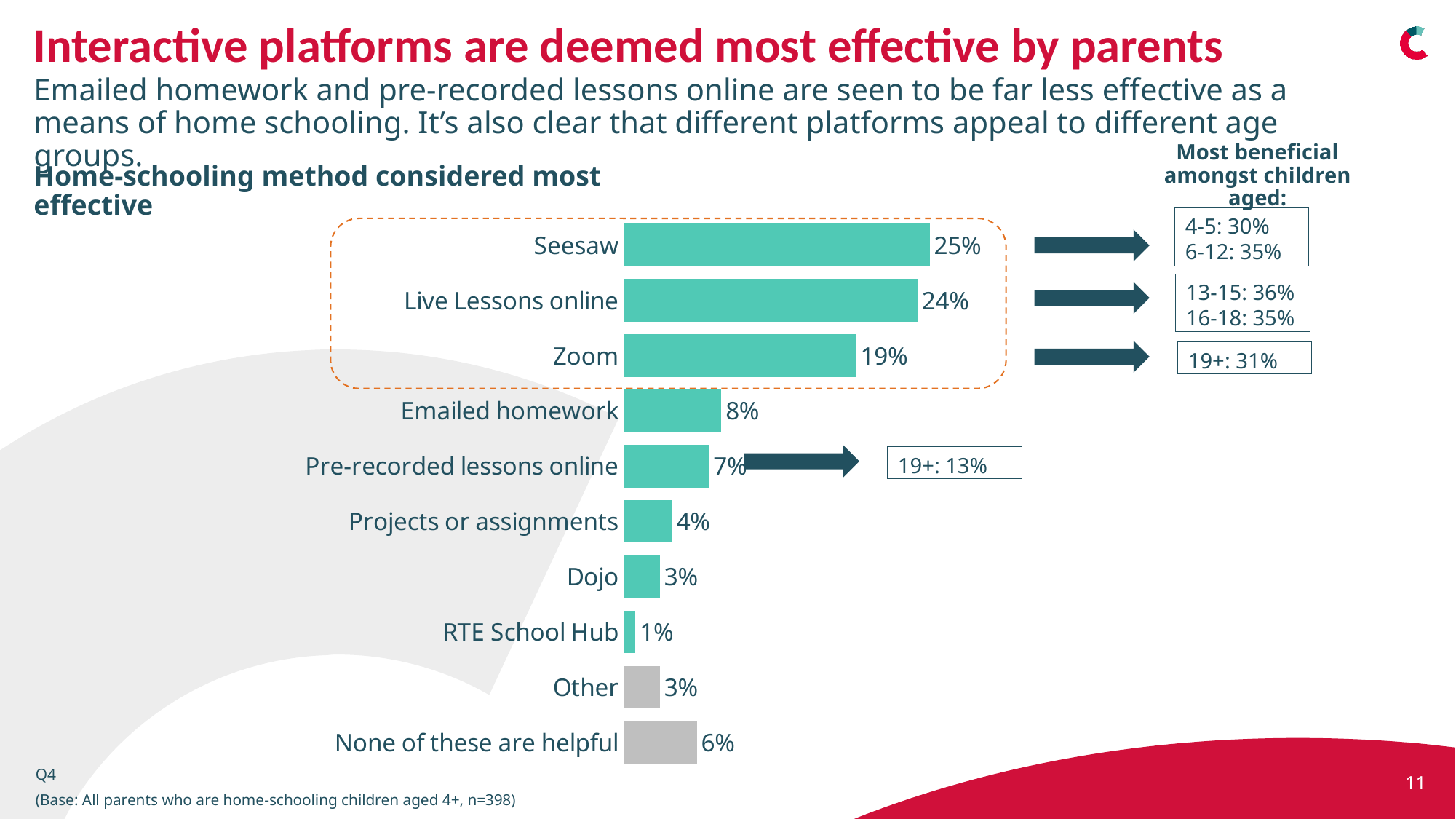
What is the value shown for Zoom? 19% Which home-schooling method has the lowest percentage? RTE School Hub What is the difference between the values for Seesaw and Zoom? 6% What is the difference between the values for Emailed homework and Projects or assignments? 4% How many categories are shown in the chart? 10 Which home-schooling method has the highest percentage? Seesaw What is the title of the chart? Home-schooling method considered most effective Which has a larger value, None of these are helpful or Dojo? None of these are helpful What type of chart is shown on the slide? Bar chart What percentage of parents consider Seesaw the most effective home-schooling method? 25% What is the value shown for Emailed homework? 8% Which has a larger value, Live Lessons online or Pre-recorded lessons online? Live Lessons online